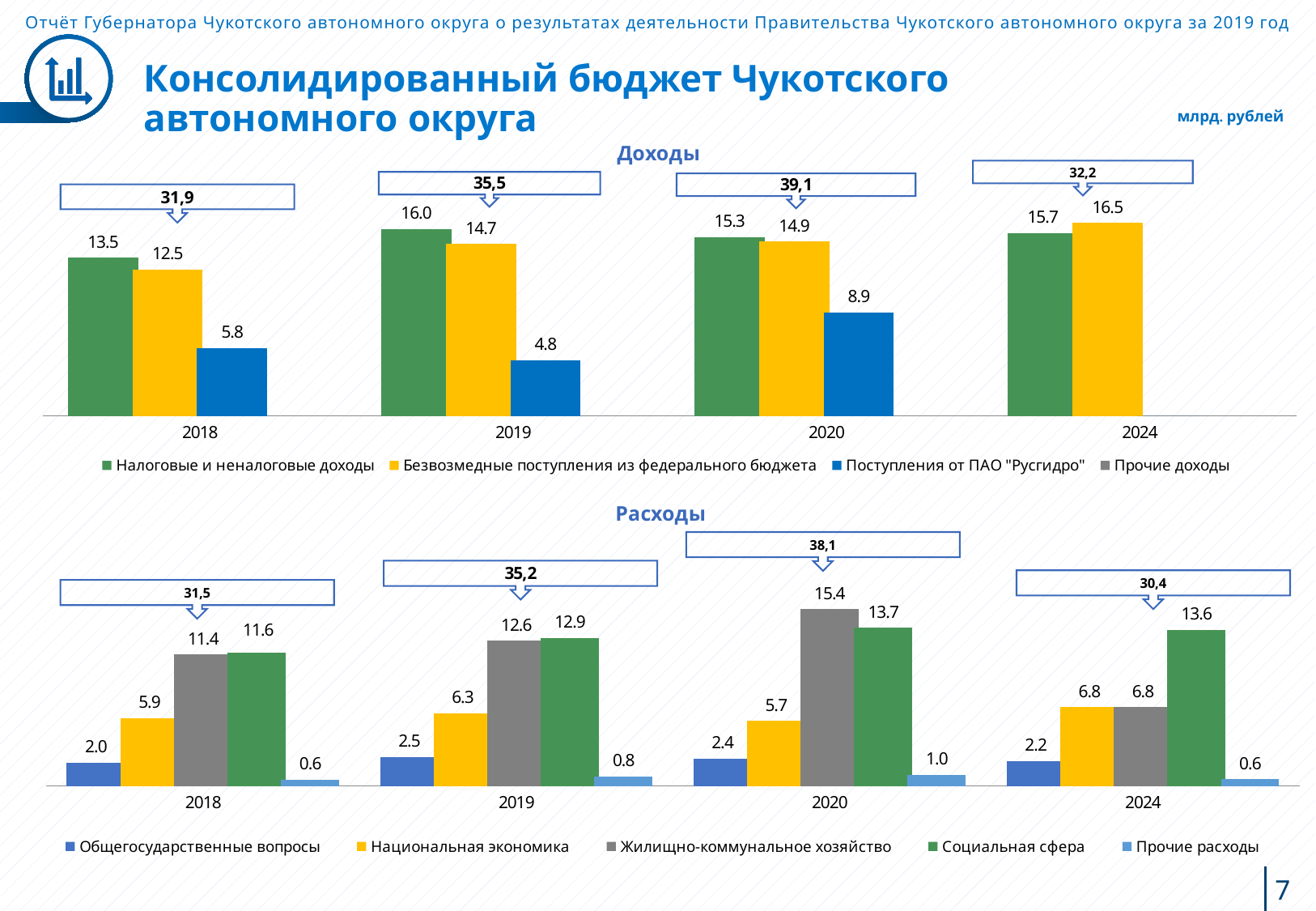
In the "Расходы" chart, how many years are shown on the x axis? 4 In the "Доходы" chart, which year has the lowest value for "Поступления от ПАО "Русгидро"" among the years where it is shown? 2019 In the "Доходы" chart, how many series does the legend list? 4 In the "Расходы" chart, what is the value of "Жилищно-коммунальное хозяйство" for 2020? 15.4 In the "Доходы" chart, what is the value of "Поступления от ПАО "Русгидро"" for 2020? 8.9 In the "Расходы" chart, which is larger in 2024: "Национальная экономика" or "Общегосударственные вопросы"? Национальная экономика In the "Доходы" chart, what total is shown in the box above the 2020 bars? 39,1 In the "Расходы" chart, what is the difference between "Социальная сфера" and "Жилищно-коммунальное хозяйство" in 2024? 6.8 In the "Доходы" chart, what is the difference between "Налоговые и неналоговые доходы" and "Безвозмездные поступления из федерального бюджета" in 2018? 1.0 In the "Доходы" chart, what is the value of "Налоговые и неналоговые доходы" for 2019? 16.0 What kind of chart is the "Расходы" chart? Bar chart In the "Расходы" chart, which year has the highest value for "Социальная сфера"? 2020